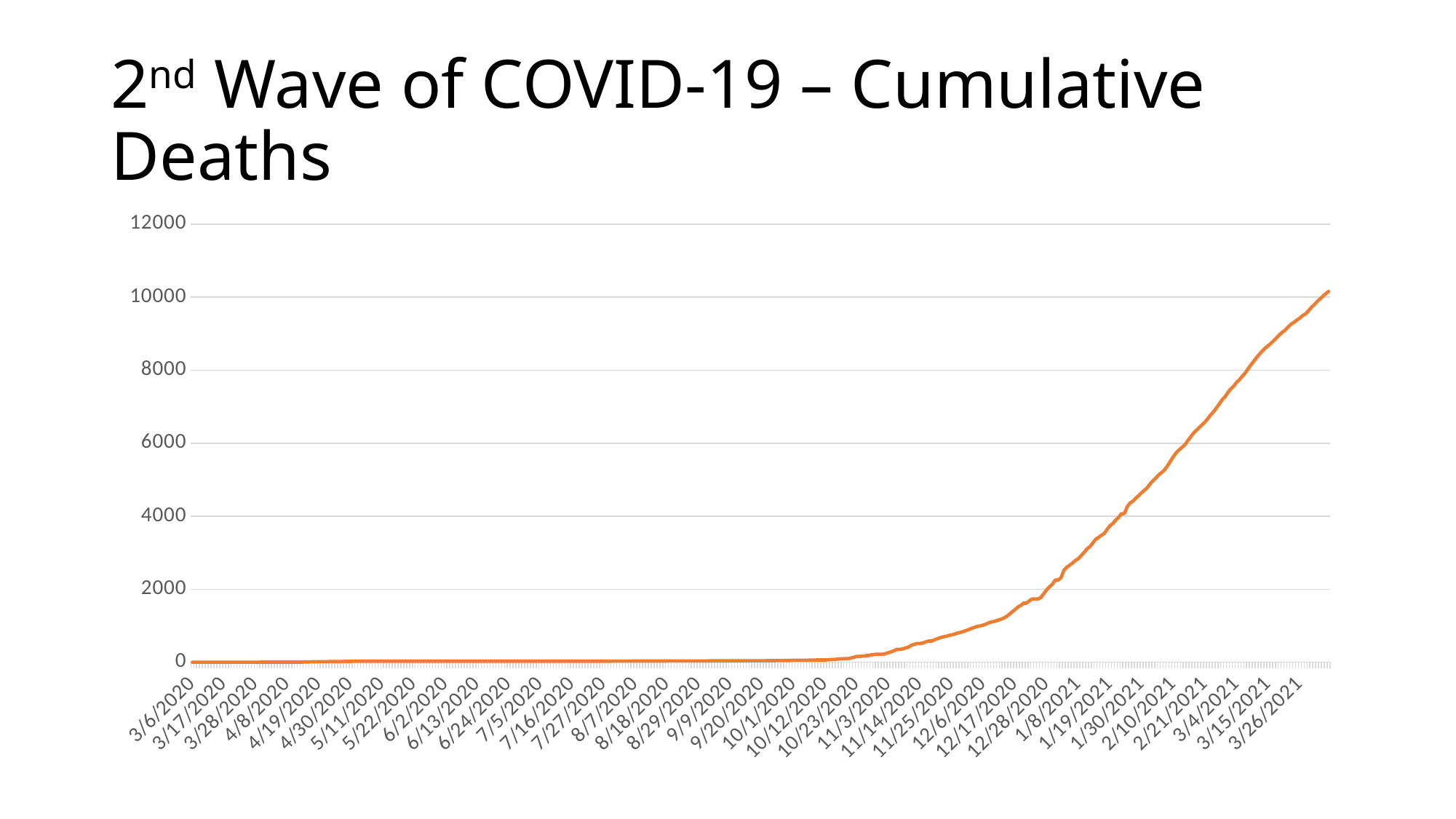
Is the value for 3/26/2021 greater or less than 8000? greater What kind of chart is shown on the slide? line chart Is the value for 10/1/2020 greater or less than 2000? less Is the value for 2/10/2021 greater or less than 4000? greater Which is larger, the value for 1/30/2021 or the value for 11/14/2020? 1/30/2021 What colour is the line on the chart? orange What is the title of the slide's chart? 2nd Wave of COVID-19 – Cumulative Deaths Do the cumulative deaths rise or fall along the x axis from 3/6/2020 to 3/26/2021? rise